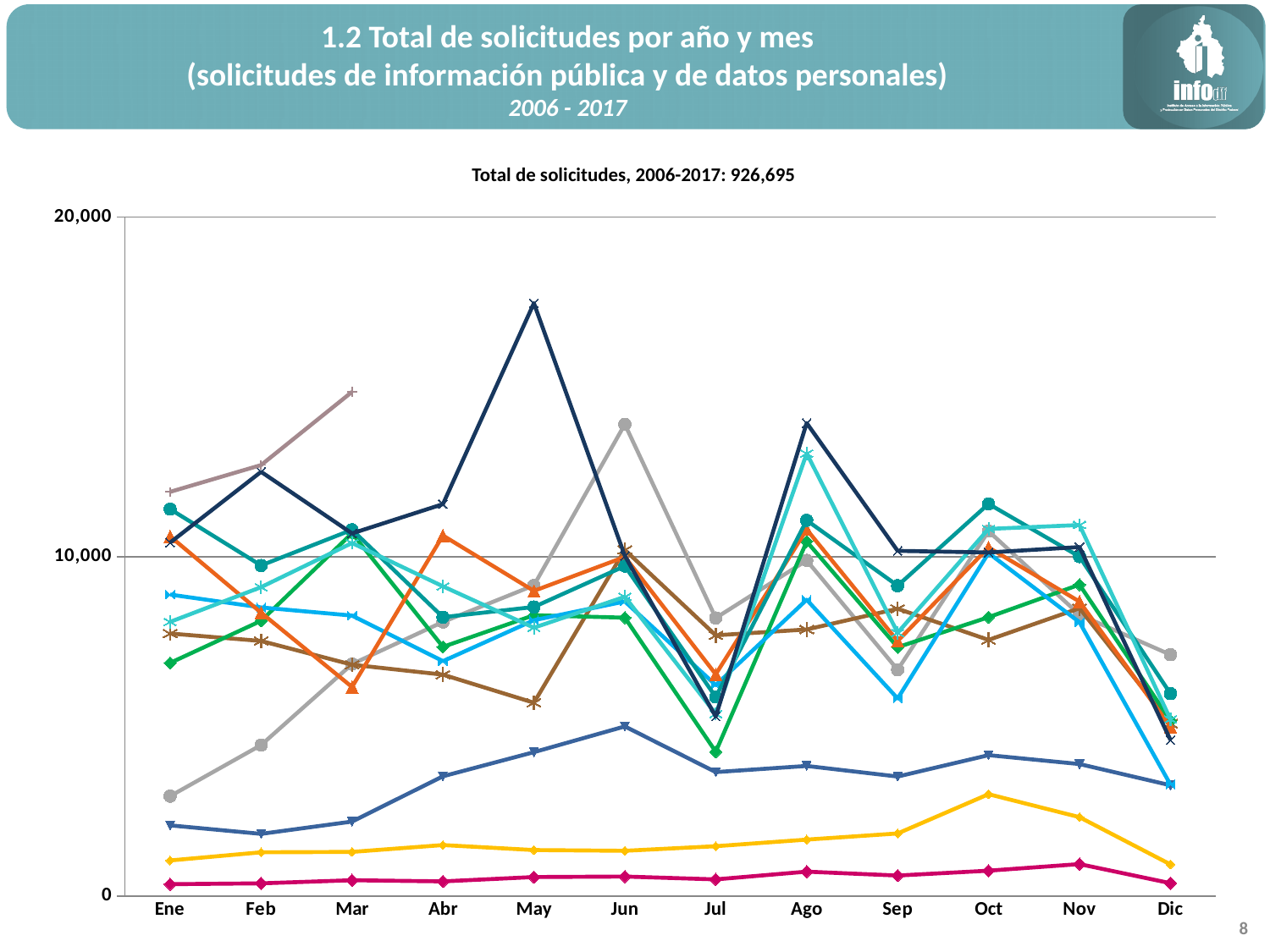
What is the highest value shown on the y axis of the chart? 20,000 What is the first month label on the x axis? Ene Is the lowest line on the chart (the magenta line) above or below 10,000 in every month? below Is the highest point on the chart (in May) greater or less than 20,000? less What total of solicitudes for 2006-2017 is printed above the chart? 926,695 In which month does the single highest point on the chart occur? May How many months are shown along the x axis of the chart? 12 Is the highest point on the chart (in May) greater or less than 10,000? greater What kind of chart is shown on the slide? line chart